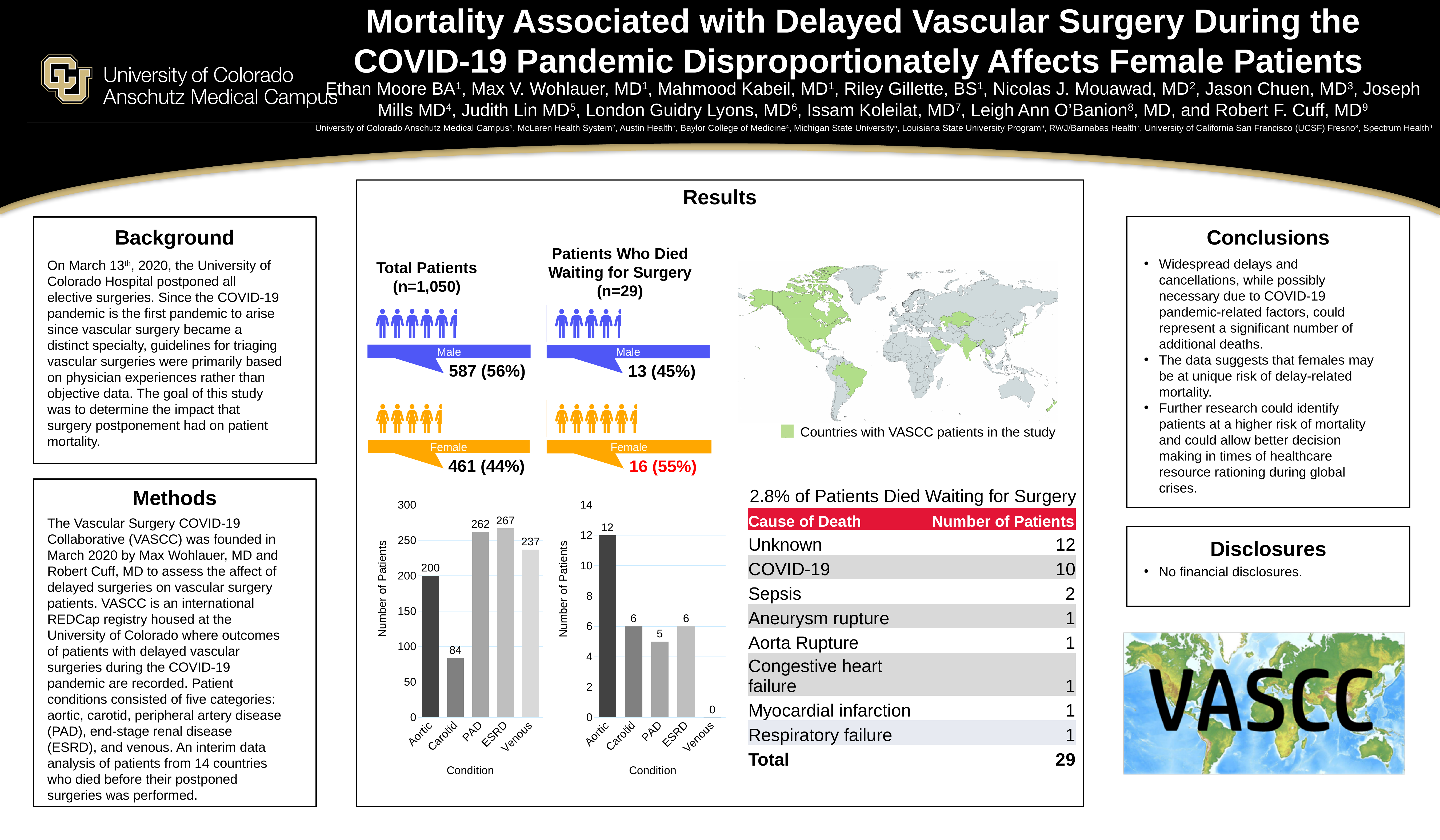
In the left bar chart (under Total Patients), which condition has the lowest number of patients? Carotid In the right bar chart (under Patients Who Died Waiting for Surgery), what is the value for Aortic? 12 In the left bar chart (under Total Patients), is the value for Venous greater or less than 200? greater In the left bar chart (Number of Patients by Condition, under Total Patients), what is the value for Carotid? 84 How many conditions are shown on the x axis of the right bar chart (under Patients Who Died Waiting for Surgery)? 5 In the right bar chart (under Patients Who Died Waiting for Surgery), what is the value for Venous? 0 In the left bar chart (under Total Patients), which condition has the highest number of patients? ESRD What is the y-axis label of the left bar chart (under Total Patients)? Number of Patients In the right bar chart (under Patients Who Died Waiting for Surgery), which condition has the highest value? Aortic What kind of chart is the left chart under Total Patients? bar chart In the left bar chart (under Total Patients), what is the difference between the values for PAD and Aortic? 62 In the right bar chart (under Patients Who Died Waiting for Surgery), which is larger, the value for Carotid or the value for PAD? Carotid